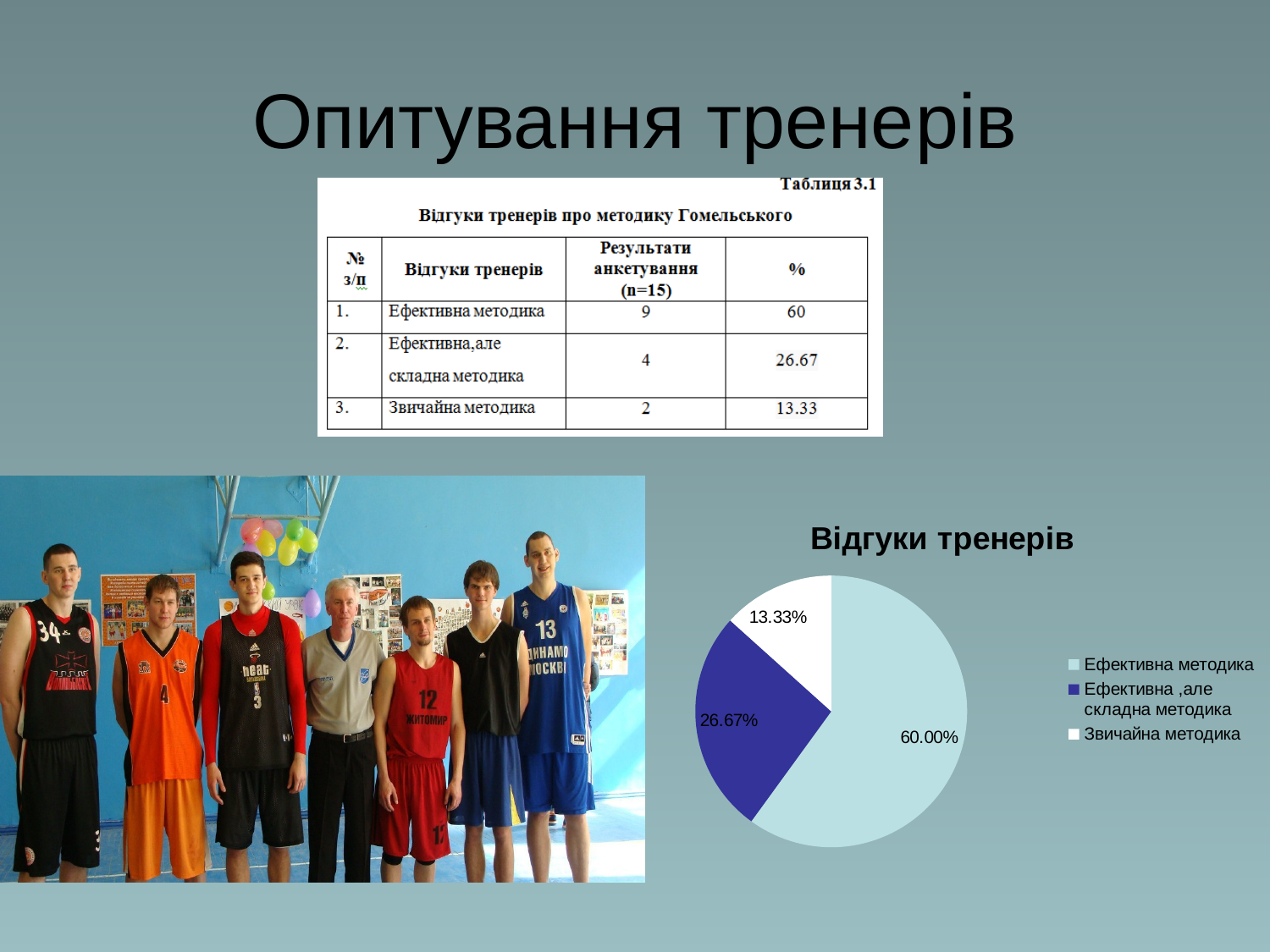
What is the difference in percentage points between the "Ефективна методика" slice and the "Звичайна методика" slice? 46.67 What is the title of the chart? Відгуки тренерів Which legend entry is shown in dark blue? Ефективна ,але складна методика What type of chart is shown on the slide? pie chart Which category has the smallest slice of the pie? Звичайна методика Which slice is larger: "Ефективна ,але складна методика" or "Звичайна методика"? Ефективна ,але складна методика What share of the pie is labelled for "Ефективна методика"? 60.00% What share of the pie is labelled for "Звичайна методика"? 13.33% Which category has the largest slice of the pie? Ефективна методика How many entries does the chart legend list? 3 What share of the pie is labelled for "Ефективна ,але складна методика"? 26.67% How many slices does the pie chart have? 3